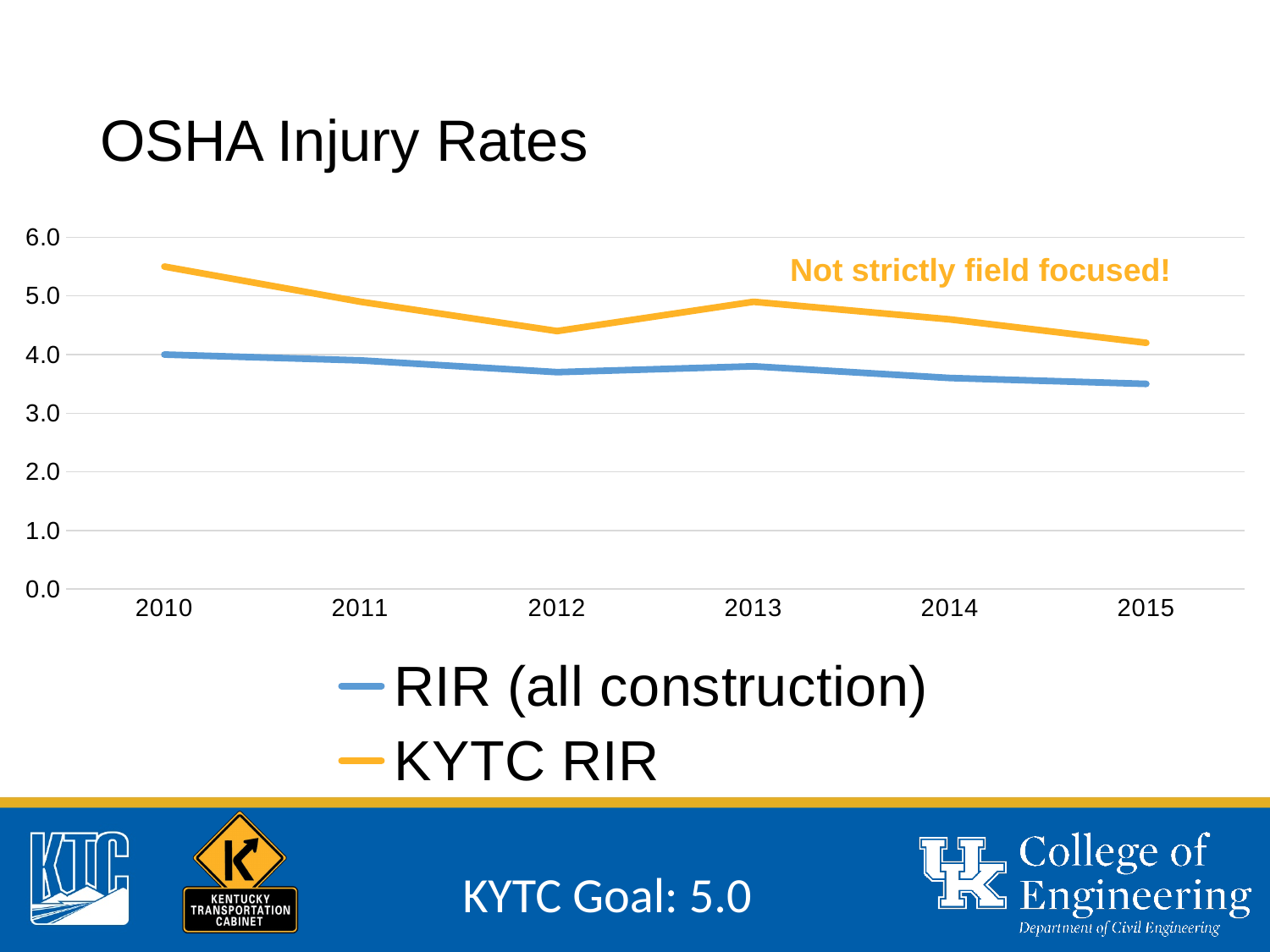
Is the KYTC RIR value for 2012 greater or less than 5.0? less In which year is the KYTC RIR highest? 2010 What kind of chart is shown on the slide? line chart What is the title of the chart? OSHA Injury Rates Is the KYTC RIR value for 2010 greater or less than 5.0? greater How many series does the legend list? 2 Does the KYTC RIR line overall rise or fall from 2010 to 2015? fall How many years are shown on the x axis? 6 In which year is the KYTC RIR lowest? 2015 What colour is the line for KYTC RIR? orange Is the RIR (all construction) value for 2015 greater or less than 4.0? less In 2010, which series has the higher value: KYTC RIR or RIR (all construction)? KYTC RIR